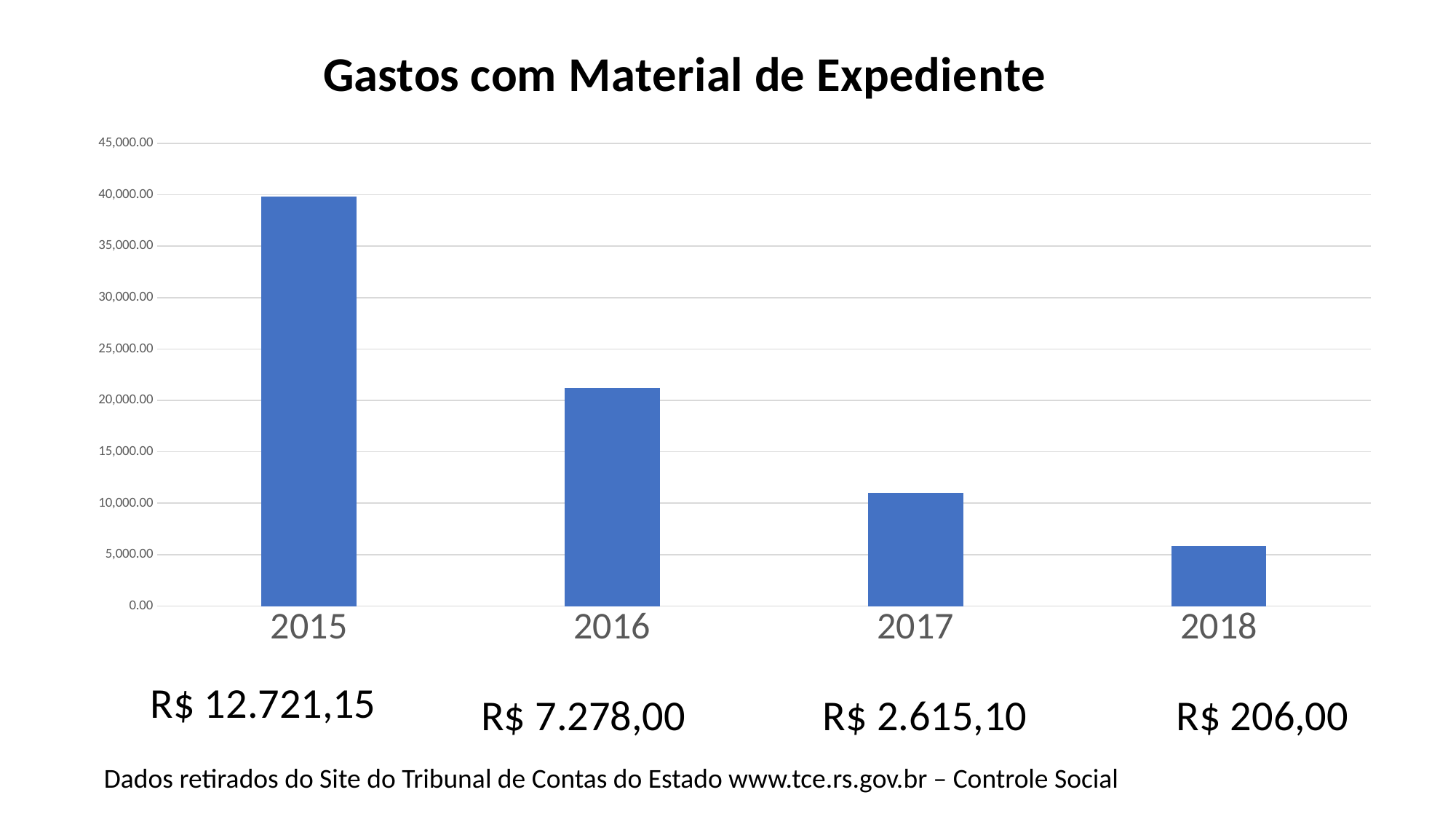
Which year has the highest bar in the chart? 2015 What is the title of the chart? Gastos com Material de Expediente Which year has the lowest bar in the chart? 2018 Is the bar for 2017 greater or less than 15,000.00? less What kind of chart is shown on the slide? bar chart Which year has the taller bar, 2016 or 2017? 2016 Is the bar for 2015 greater or less than 35,000.00? greater Is the bar for 2016 greater or less than 25,000.00? less What is the highest value shown on the vertical axis of the chart? 45,000.00 Do the bar values rise or fall from 2015 to 2018? fall How many years (bars) are plotted in the chart? 4